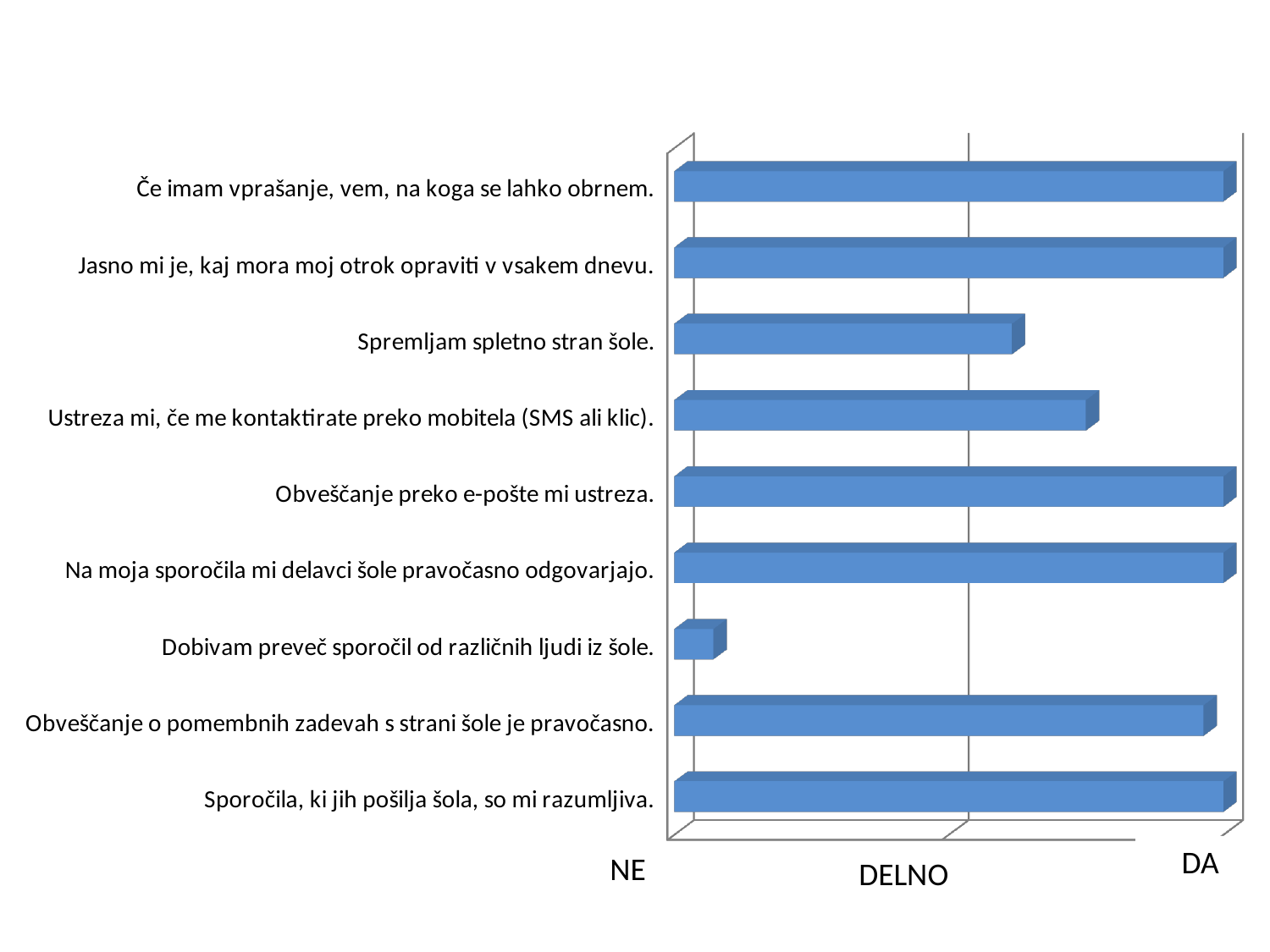
Which bar is longer: 'Spremljam spletno stran šole.' or 'Dobivam preveč sporočil od različnih ljudi iz šole.'? Spremljam spletno stran šole. Which statement has the shortest bar in the chart? Dobivam preveč sporočil od različnih ljudi iz šole. Does the bar for 'Spremljam spletno stran šole.' extend past the DELNO mark on the axis? yes What are the three labels shown on the horizontal axis of the chart? NE, DELNO, DA What kind of chart is shown on the slide? bar chart What colour are the bars in the chart? blue How many categories (statements) are plotted in the chart? 9 Does the bar for 'Dobivam preveč sporočil od različnih ljudi iz šole.' reach the DELNO mark on the axis? no Which bar is longer: 'Spremljam spletno stran šole.' or 'Ustreza mi, če me kontaktirate preko mobitela (SMS ali klic).'? Ustreza mi, če me kontaktirate preko mobitela (SMS ali klic).